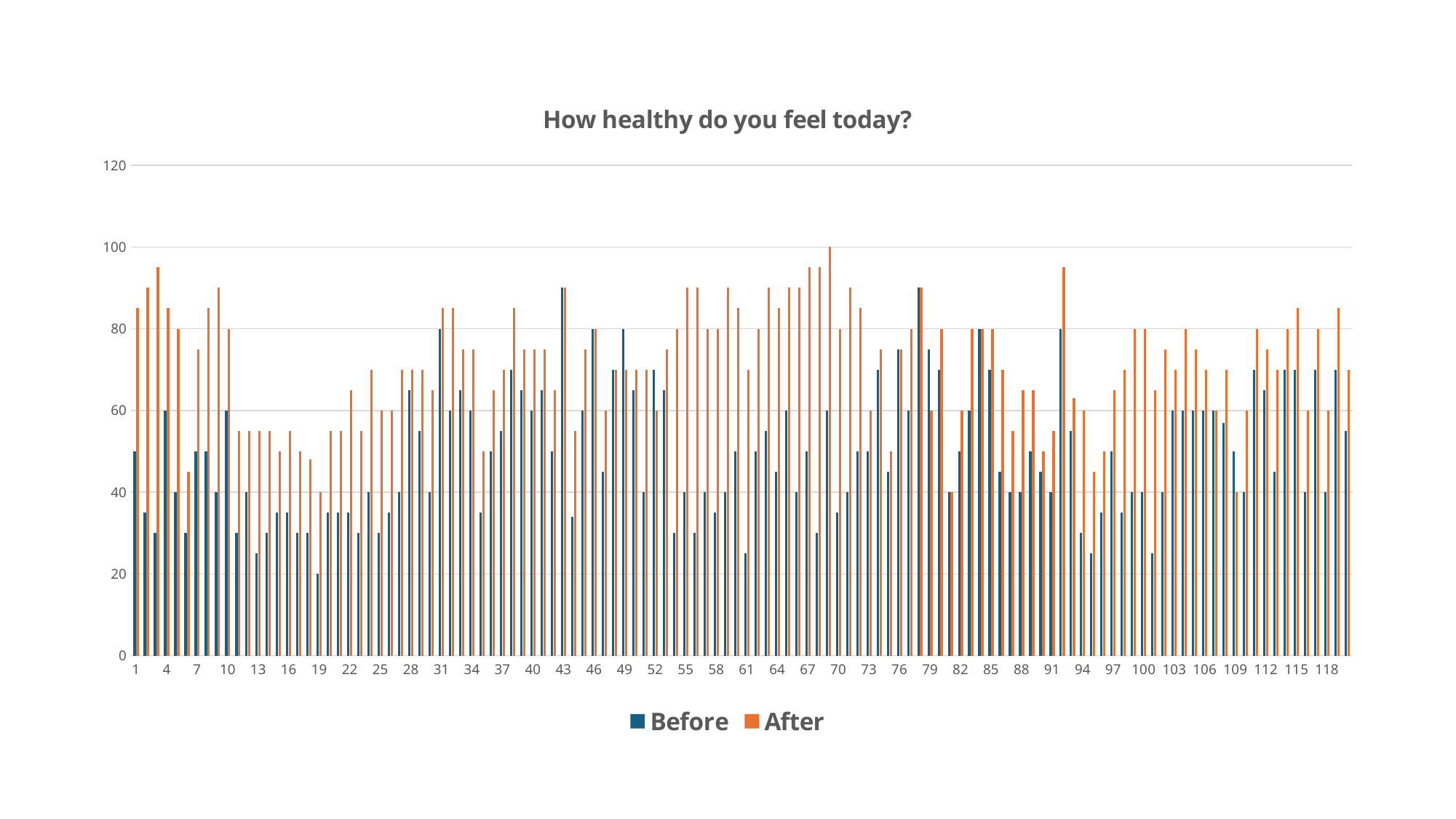
Is the After value for category 10 greater or less than 60? greater What kind of chart is shown on the slide? bar chart Is the Before value for category 1 greater or less than 40? greater For category 1, which is larger, the Before value or the After value? After Which two series are shown in the legend? Before and After How many series does the legend list? 2 For category 10, which is larger, the Before value or the After value? After Is the After value for category 1 greater or less than 80? greater What is the highest value shown on the vertical axis? 120 What is the title of the chart? How healthy do you feel today?